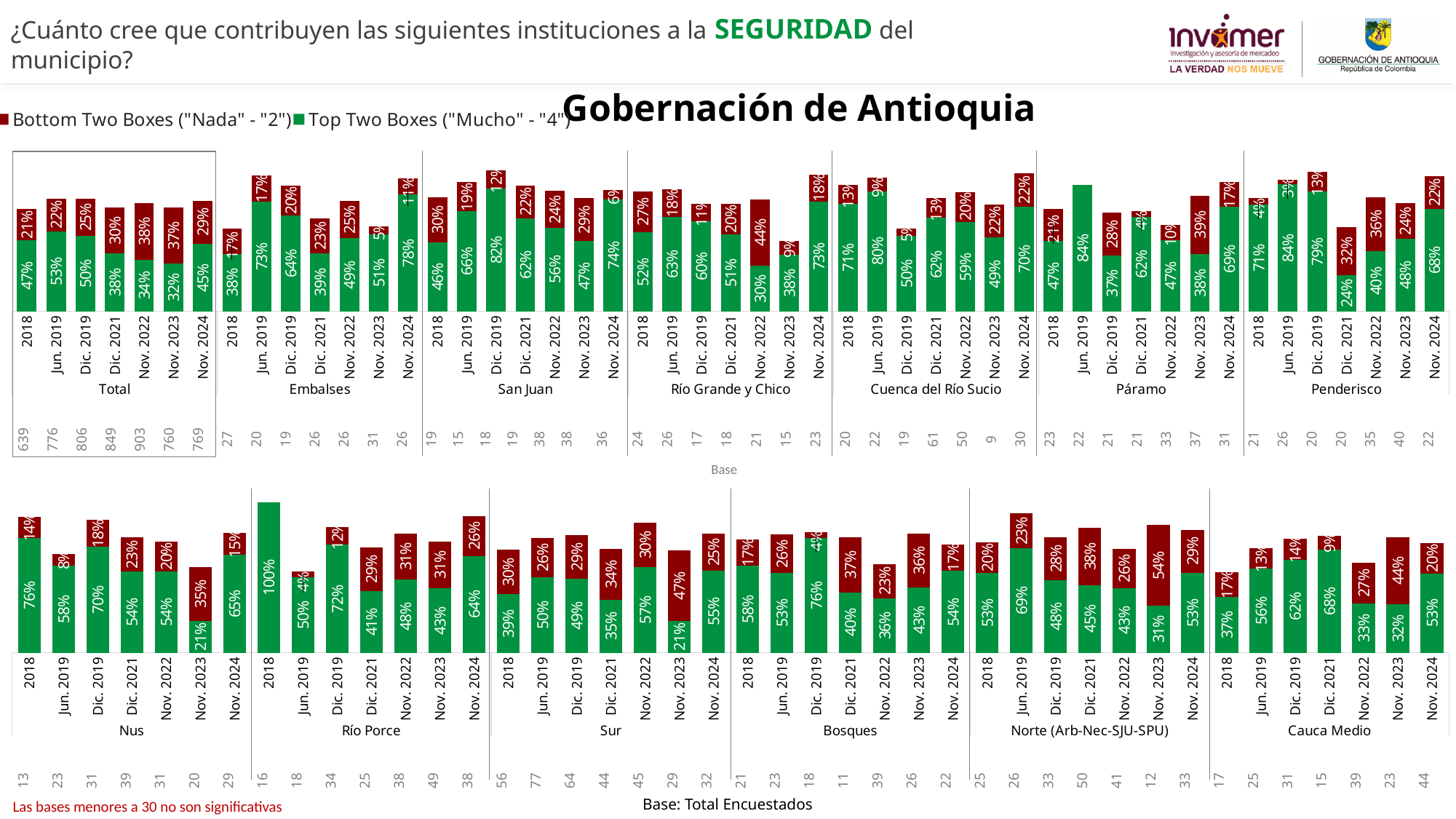
Which is larger for Sur in Nov. 2023: the Top Two Boxes value or the Bottom Two Boxes value? Bottom Two Boxes Within the Total group, which period has the highest Top Two Boxes value? Jun. 2019 What is the Bottom Two Boxes value for Total in Nov. 2022? 38% What is the base (number of respondents) for Total in Nov. 2022? 903 What is the Top Two Boxes value for Total in Nov. 2024? 45% What is the Top Two Boxes value for Río Porce in 2018? 100% What is the difference between the Top Two Boxes values for San Juan in Dic. 2019 and 2018? 36 percentage points How many series does the legend list? 2 Within the Total group, which period has the lowest Top Two Boxes value? Nov. 2023 What is the combined total of Top Two Boxes and Bottom Two Boxes for Total in 2018? 68% What is the Bottom Two Boxes value for Norte (Arb-Nec-SJU-SPU) in Nov. 2023? 54% What type of chart is shown on the slide? Stacked bar chart